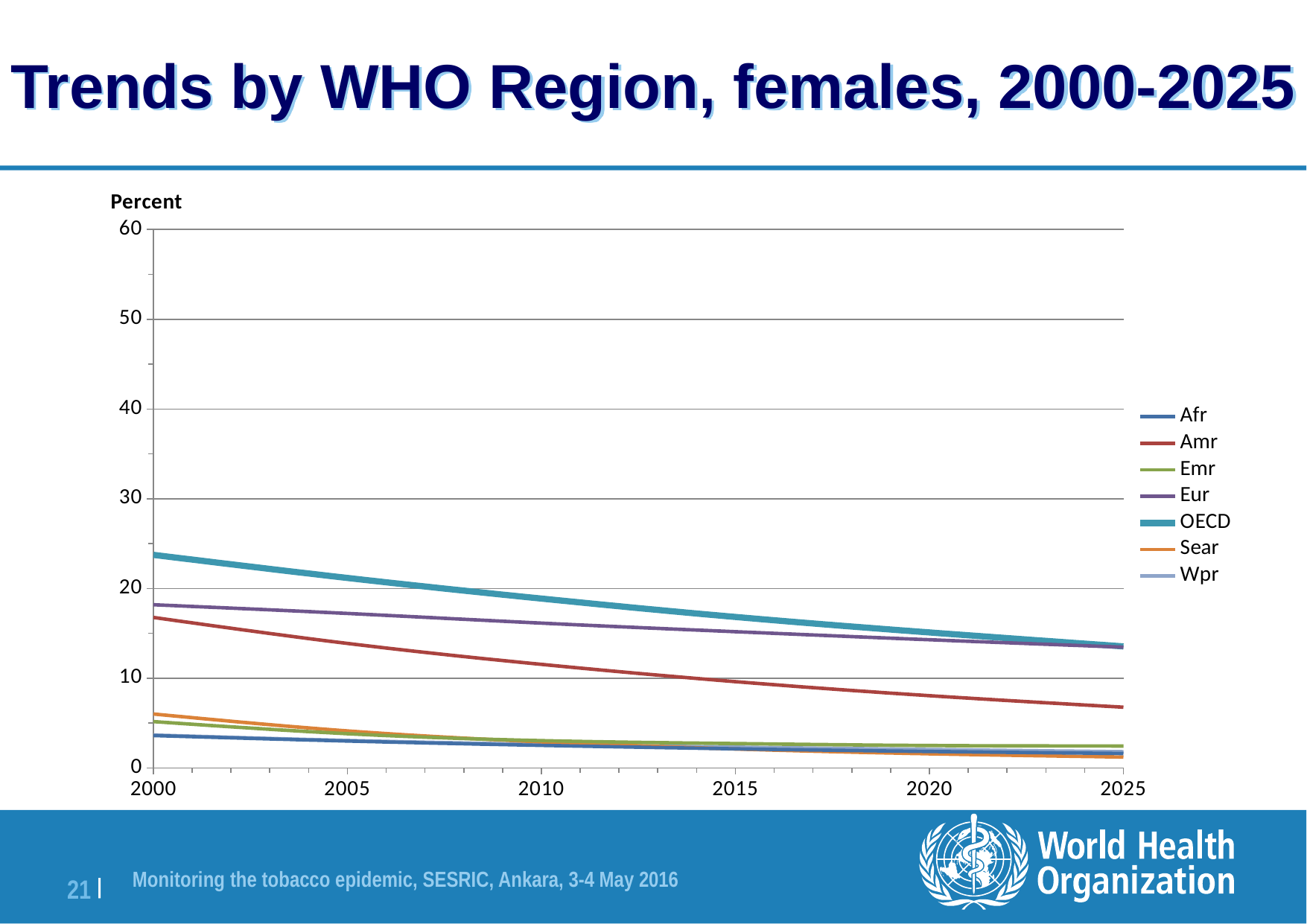
What is the label on the vertical axis of the chart? Percent Which region has the highest value in 2000? OECD In 2000, which is larger, the value for OECD or the value for Amr? OECD How many series does the legend list? 7 Is the value for Sear in 2000 greater or less than 10? less In 2025, which is larger, the value for Eur or the value for Amr? Eur What kind of chart is shown on the slide? line chart Is the value for Amr in 2025 greater or less than 10? less Is the value for Eur in 2025 greater or less than 10? greater Does the Amr line rise or fall from 2000 to 2025? fall